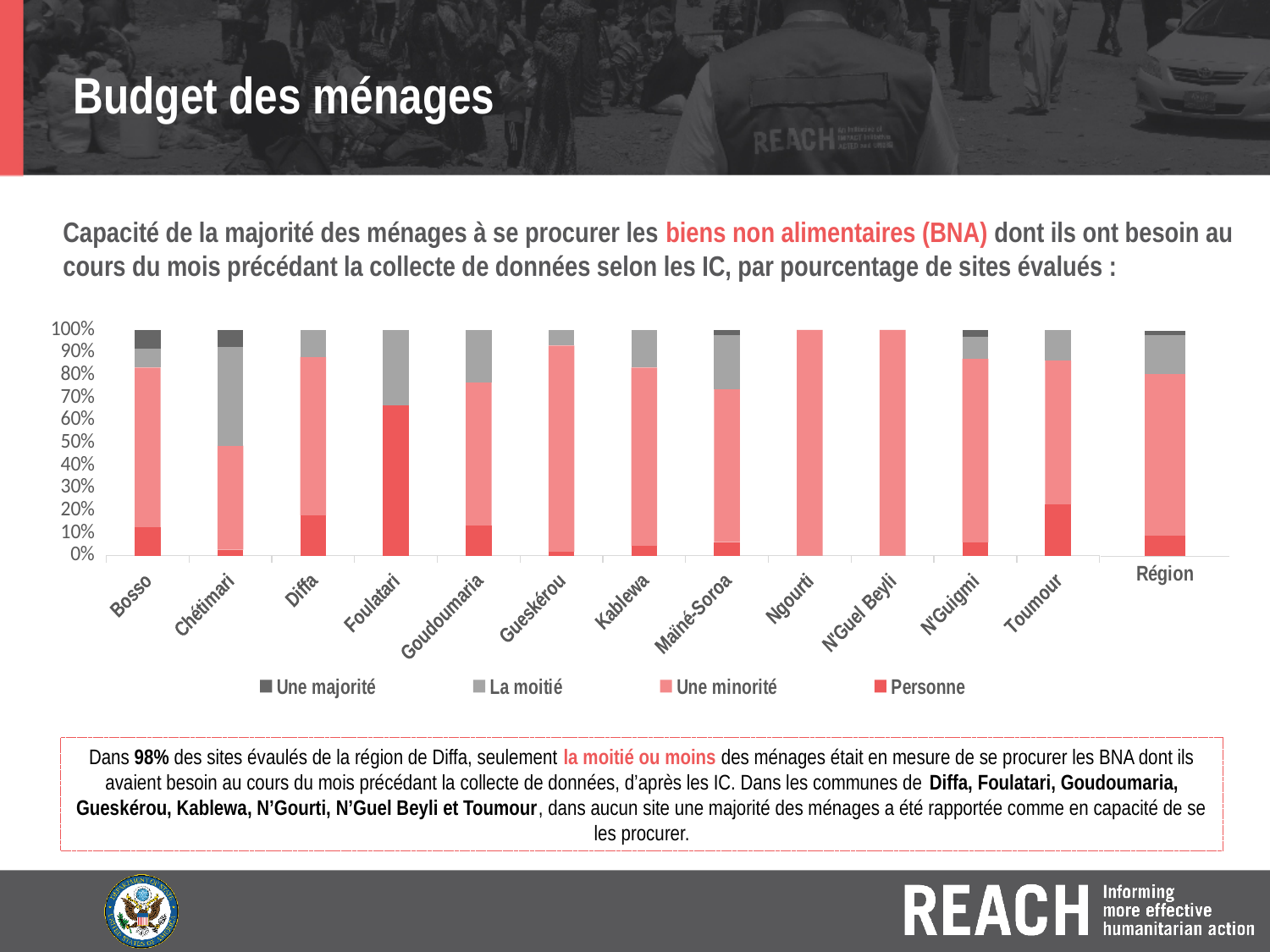
Which is larger, the 'Personne' value for Foulatari or for Toumour? Foulatari Is the 'Personne' value for Diffa greater or less than 10%? greater Is the 'Personne' value for Toumour greater or less than 30%? less How many series does the chart legend list? 4 Which legend entry is shown in red? Personne What is the total of the stacked bar for Bosso? 100% What kind of chart is shown on the slide? Stacked bar chart Is the 'Personne' value for Foulatari greater or less than 50%? greater Which legend entry is shown in dark grey? Une majorité What is the 'Une minorité' value for Ngourti? 100% Which category has the largest 'Personne' segment? Foulatari How many categories are shown along the x axis of the chart? 13